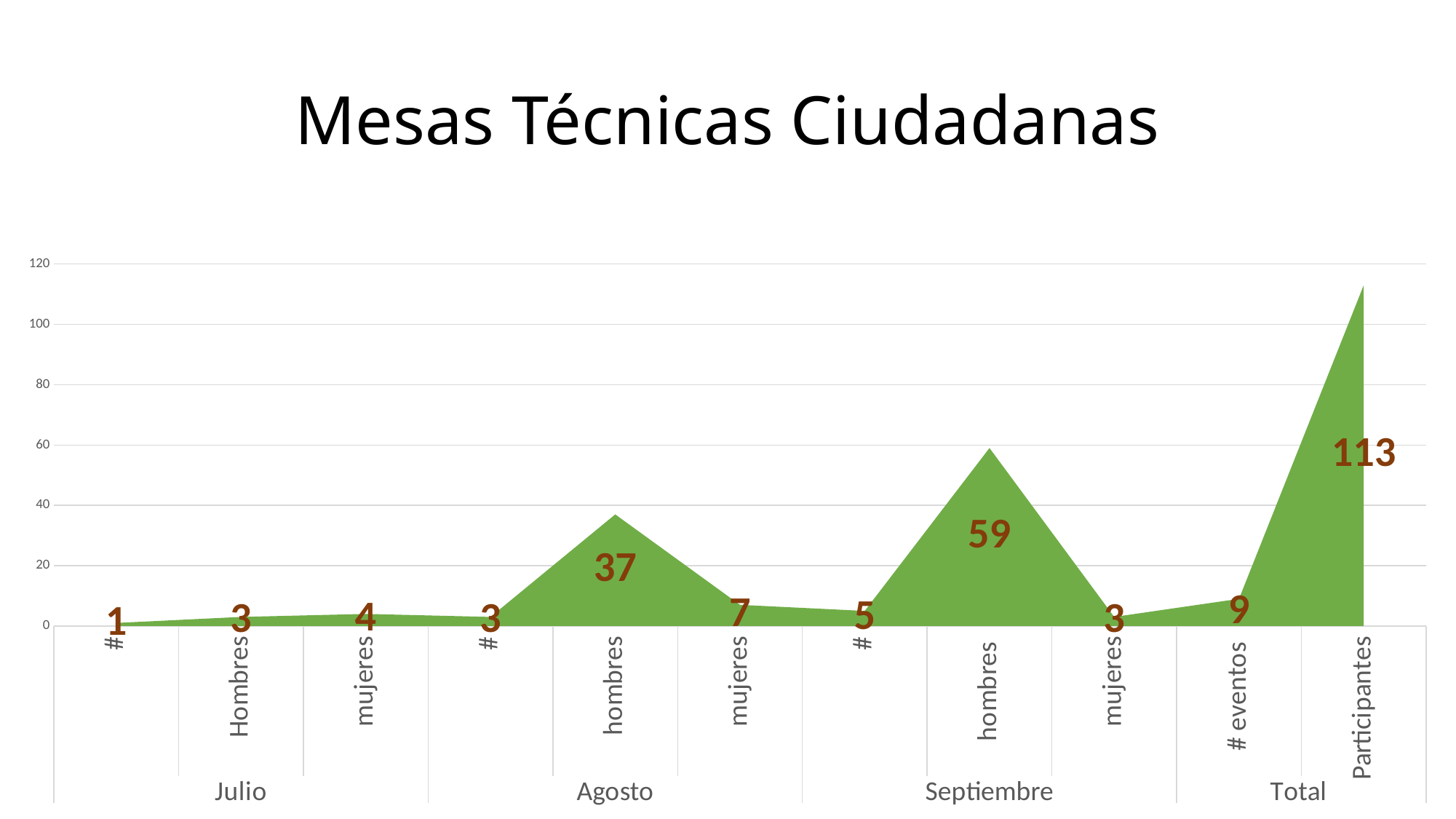
What is the value for hombres in Agosto? 37 What is the value for Participantes under Total? 113 Which is larger, mujeres in Agosto or mujeres in Septiembre? mujeres in Agosto How many data points are plotted in the chart? 11 What kind of chart is shown on the slide? Area chart What is the value for mujeres in Julio? 4 What is the value for # eventos under Total? 9 Which category has the lowest value? # (Julio) Which category has the highest value? Participantes What is the difference between hombres in Septiembre and hombres in Agosto? 22 What is the value for hombres in Septiembre? 59 What is the title of the slide? Mesas Técnicas Ciudadanas